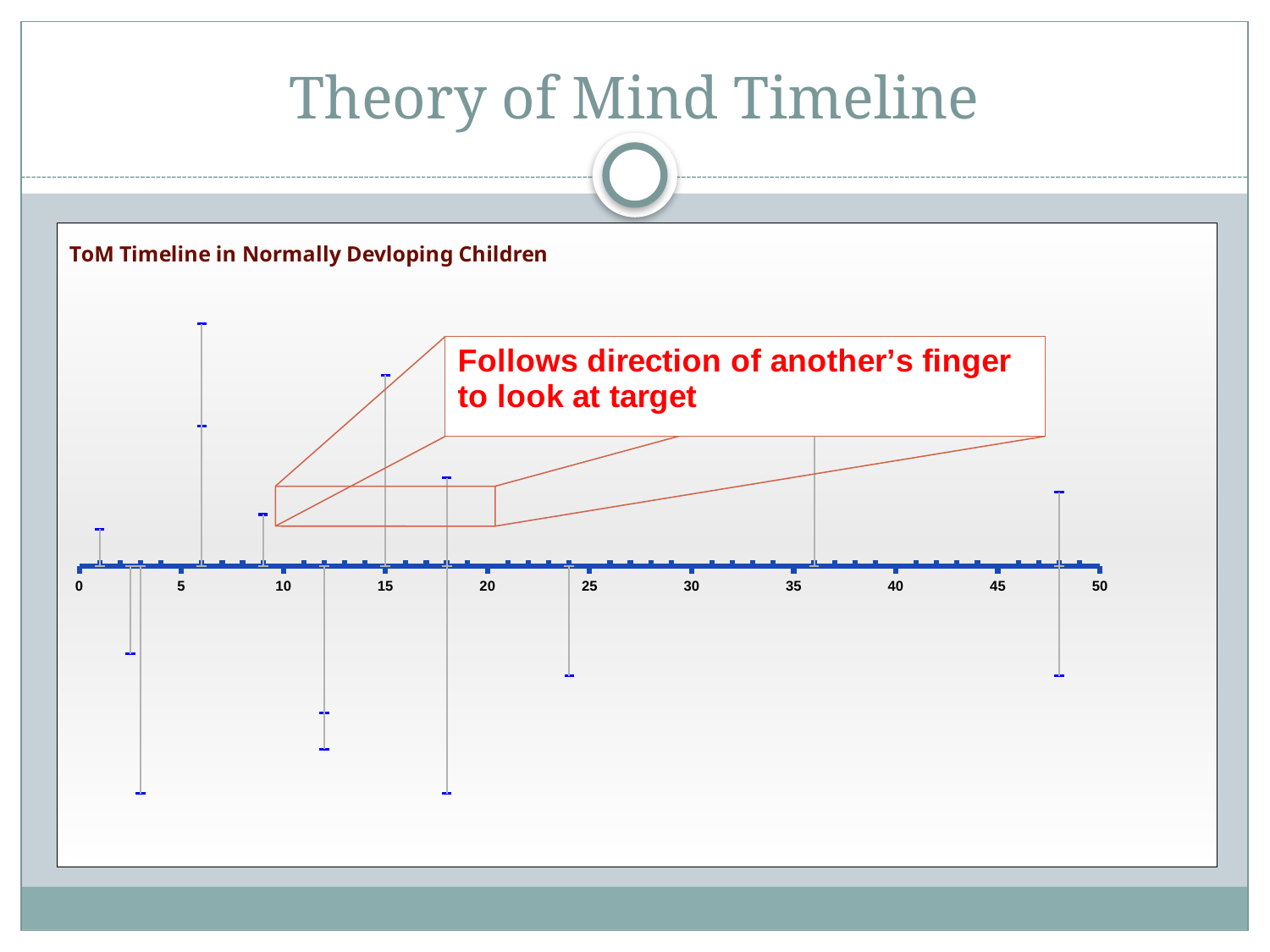
What is the interval between consecutive labelled ticks on the horizontal axis? 5 How many labelled tick values are shown on the horizontal axis? 11 What is the title of the chart on the slide? ToM Timeline in Normally Devloping Children What milestone is described in the callout box on the chart? Follows direction of another's finger to look at target What is the highest value labelled on the horizontal axis of the chart? 50 What is the lowest value labelled on the horizontal axis of the chart? 0